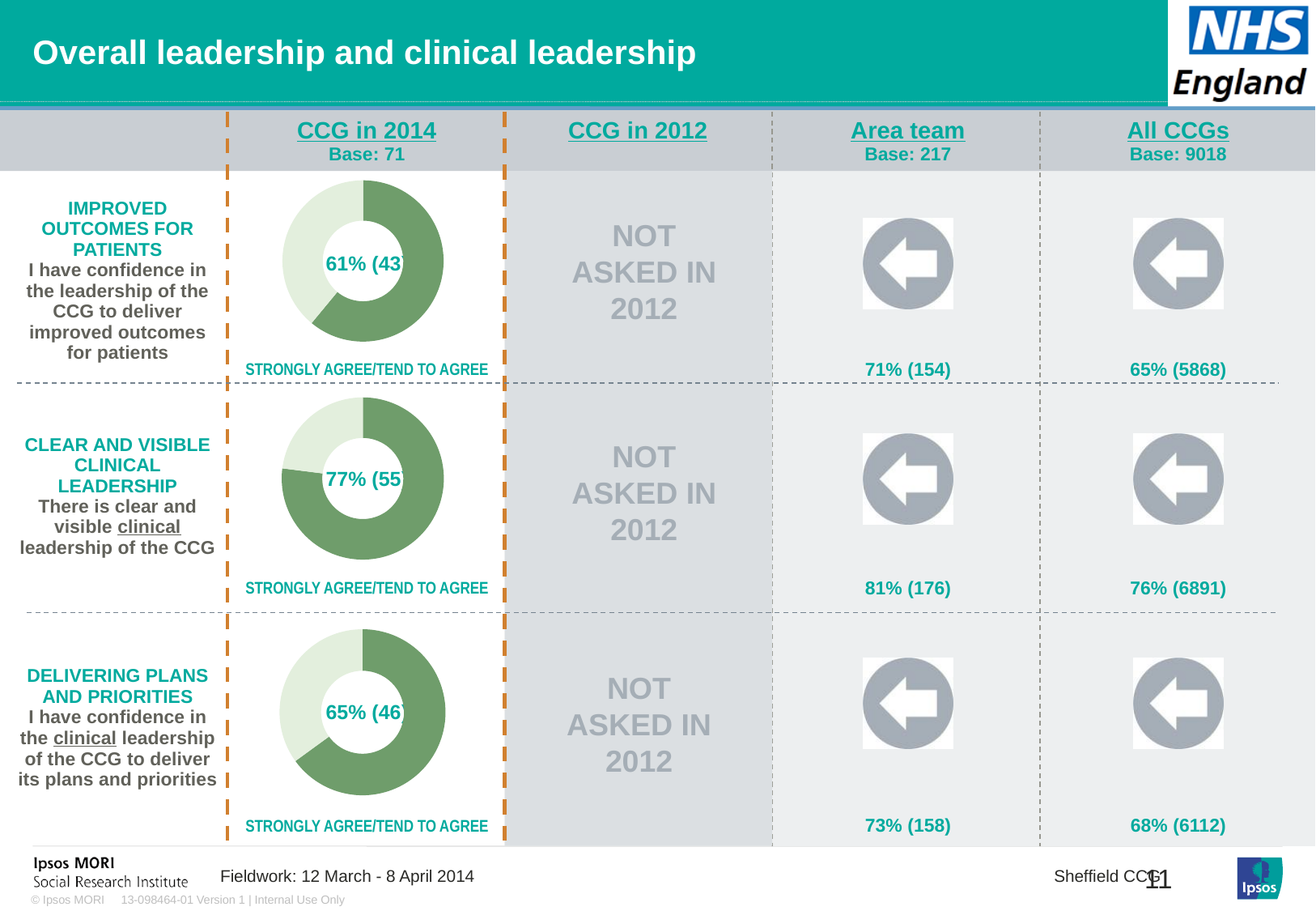
Which of the three donut charts in the 'CCG in 2014' column shows the lowest percentage? Improved outcomes for patients In the 'CCG in 2014' column, what value is shown in the donut chart for 'Improved outcomes for patients'? 61% (43) In the 'CCG in 2014' column, what value is shown in the donut chart for 'Delivering plans and priorities'? 65% (46) In the 'CCG in 2014' column, what value is shown in the donut chart for 'Clear and visible clinical leadership'? 77% (55) How many donut charts are shown on the slide? 3 Which donut chart shows a larger percentage: 'Delivering plans and priorities' or 'Improved outcomes for patients'? Delivering plans and priorities What is the difference in percentage points between the 'Clear and visible clinical leadership' donut (77%) and the 'Improved outcomes for patients' donut (61%)? 16 percentage points What kind of chart is used in the 'CCG in 2014' column? Donut (pie) chart What share of the bottom donut chart ('Delivering plans and priorities') does the dark green segment represent? 65% Which of the three donut charts in the 'CCG in 2014' column shows the highest percentage? Clear and visible clinical leadership In the top donut chart ('Improved outcomes for patients'), is the light green segment greater or less than 50% of the chart? less What label appears beneath each donut chart in the 'CCG in 2014' column? STRONGLY AGREE/TEND TO AGREE